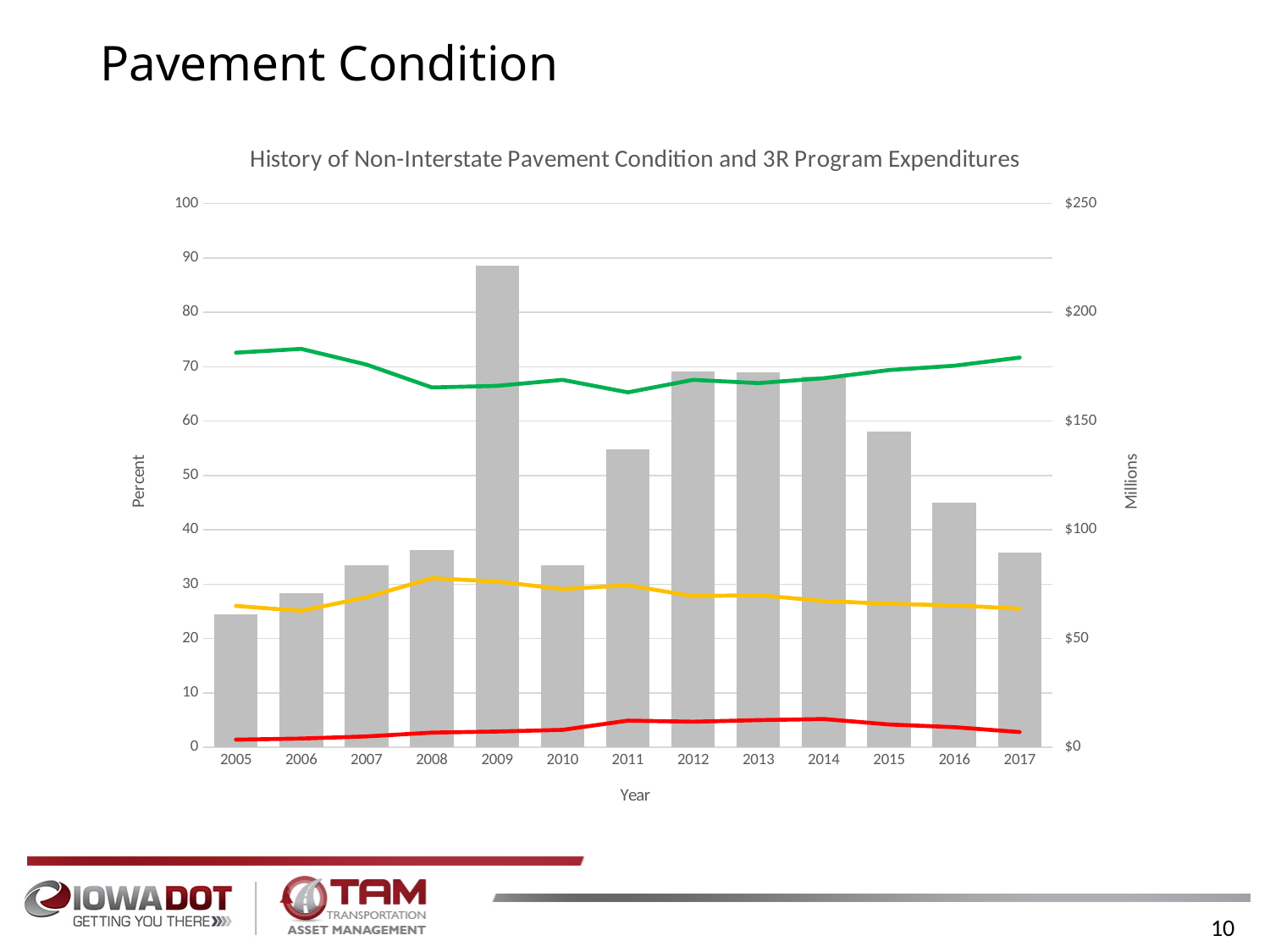
Is the red line's value for 2014 greater or less than 10 percent? less In which year is the gray bar the shortest? 2005 What is the title of the chart? History of Non-Interstate Pavement Condition and 3R Program Expenditures What kind of chart is shown on the slide? A combination bar and line chart What is the label on the right-hand vertical axis? Millions Which is taller, the gray bar for 2009 or the gray bar for 2012? 2009 In which year is the gray bar the tallest? 2009 Do the gray bars rise or fall from 2014 to 2017? fall Is the gray bar for 2009 greater or less than $200 on the right axis? greater How many years are shown along the x axis of the chart? 13 Is the gray bar for 2017 greater or less than $100 on the right axis? less